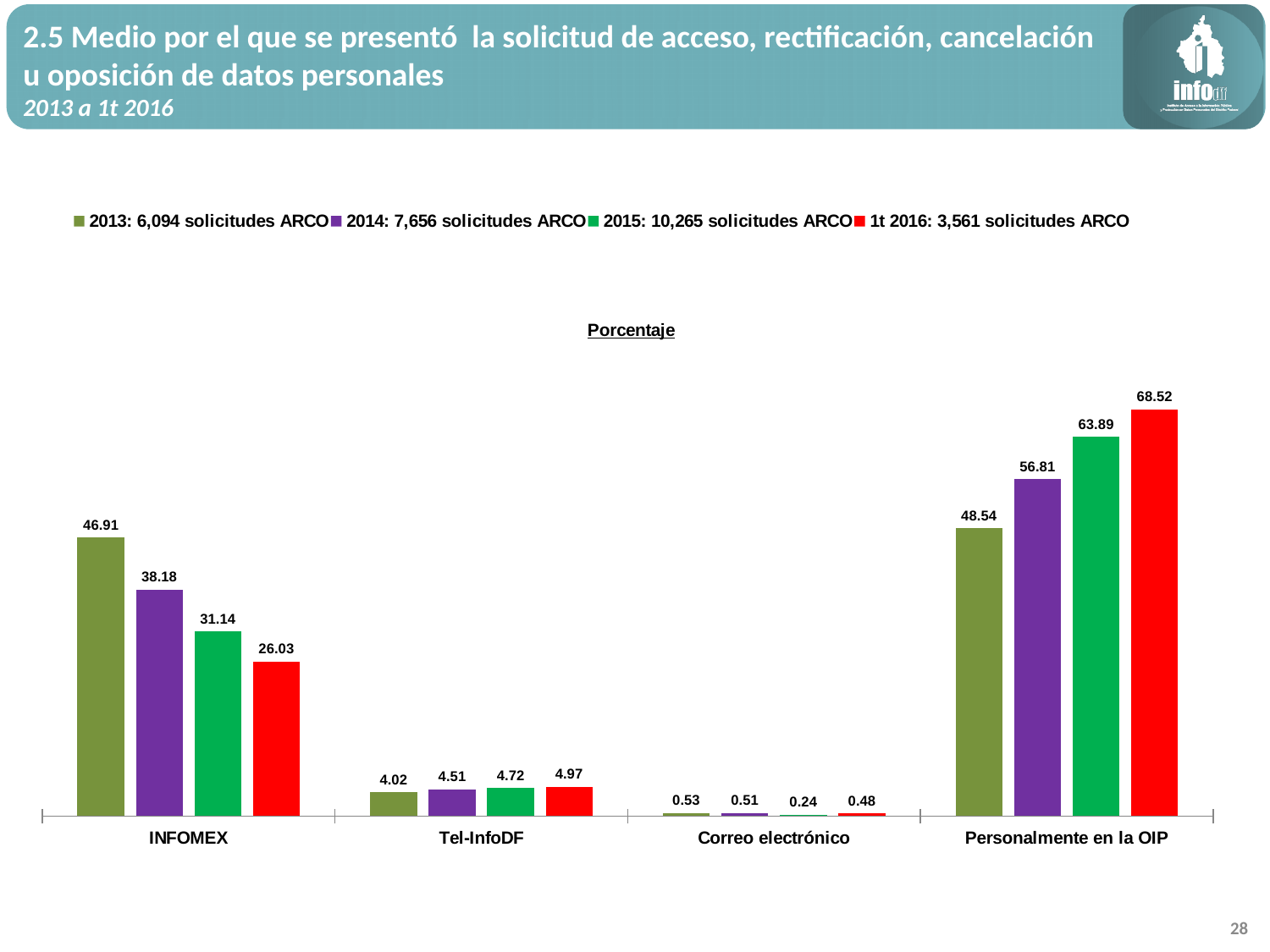
Which category has the lowest value in the 2015 series? Correo electrónico How many series does the legend list? 4 What is the value for Correo electrónico in the 2014 series? 0.51 What is the value for Personalmente en la OIP in the 1t 2016 series? 68.52 How many categories are shown on the x axis? 4 Do the values for INFOMEX rise or fall from 2013 to 1t 2016? Fall What is the value for INFOMEX in the 2013 series? 46.91 What is the difference between the 2013 and 1t 2016 values for INFOMEX? 20.88 What is the value for Tel-InfoDF in the 2015 series? 4.72 What kind of chart is shown on the slide? Bar chart Which is larger for Personalmente en la OIP: the 2014 value or the 2015 value? 2015 Which category has the highest value in the 1t 2016 series? Personalmente en la OIP